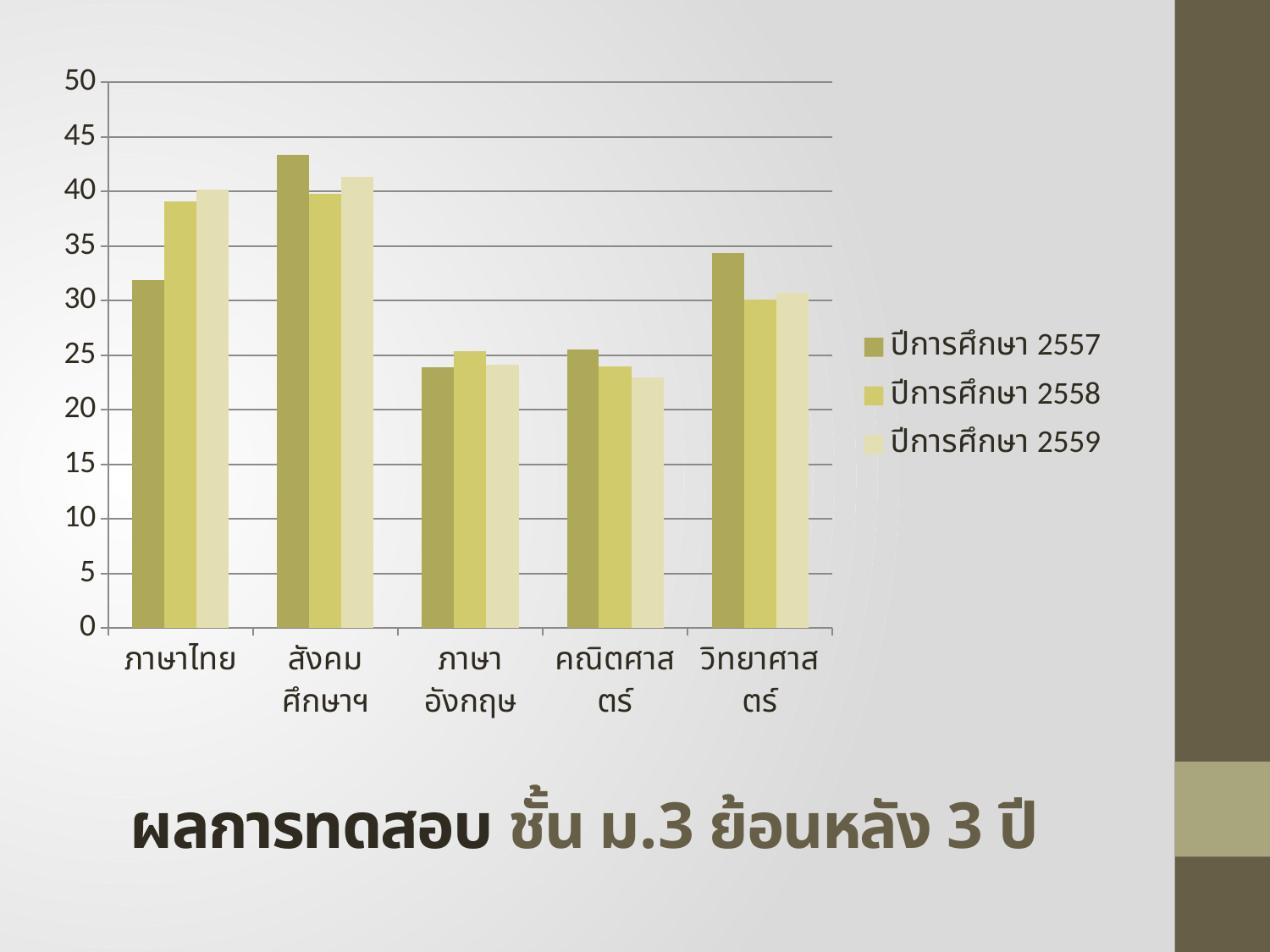
Which subject has the highest value for ปีการศึกษา 2557? สังคมศึกษาฯ For วิทยาศาสตร์, which is larger: the value for ปีการศึกษา 2557 or ปีการศึกษา 2558? ปีการศึกษา 2557 How many series does the legend list? 3 Do the values for ภาษาไทย rise or fall from ปีการศึกษา 2557 to ปีการศึกษา 2559? rise Which subject has the lowest value for ปีการศึกษา 2559? คณิตศาสตร์ What kind of chart is shown on the slide? bar chart For ภาษาไทย, which is larger: the value for ปีการศึกษา 2557 or ปีการศึกษา 2559? ปีการศึกษา 2559 How many subject categories are shown on the x axis? 5 What is the title text shown below the chart? ผลการทดสอบ ชั้น ม.3 ย้อนหลัง 3 ปี Is the value for สังคมศึกษาฯ in ปีการศึกษา 2557 greater or less than 40? greater Is the value for ภาษาไทย in ปีการศึกษา 2557 greater or less than 35? less Is the value for วิทยาศาสตร์ in ปีการศึกษา 2558 greater or less than 35? less